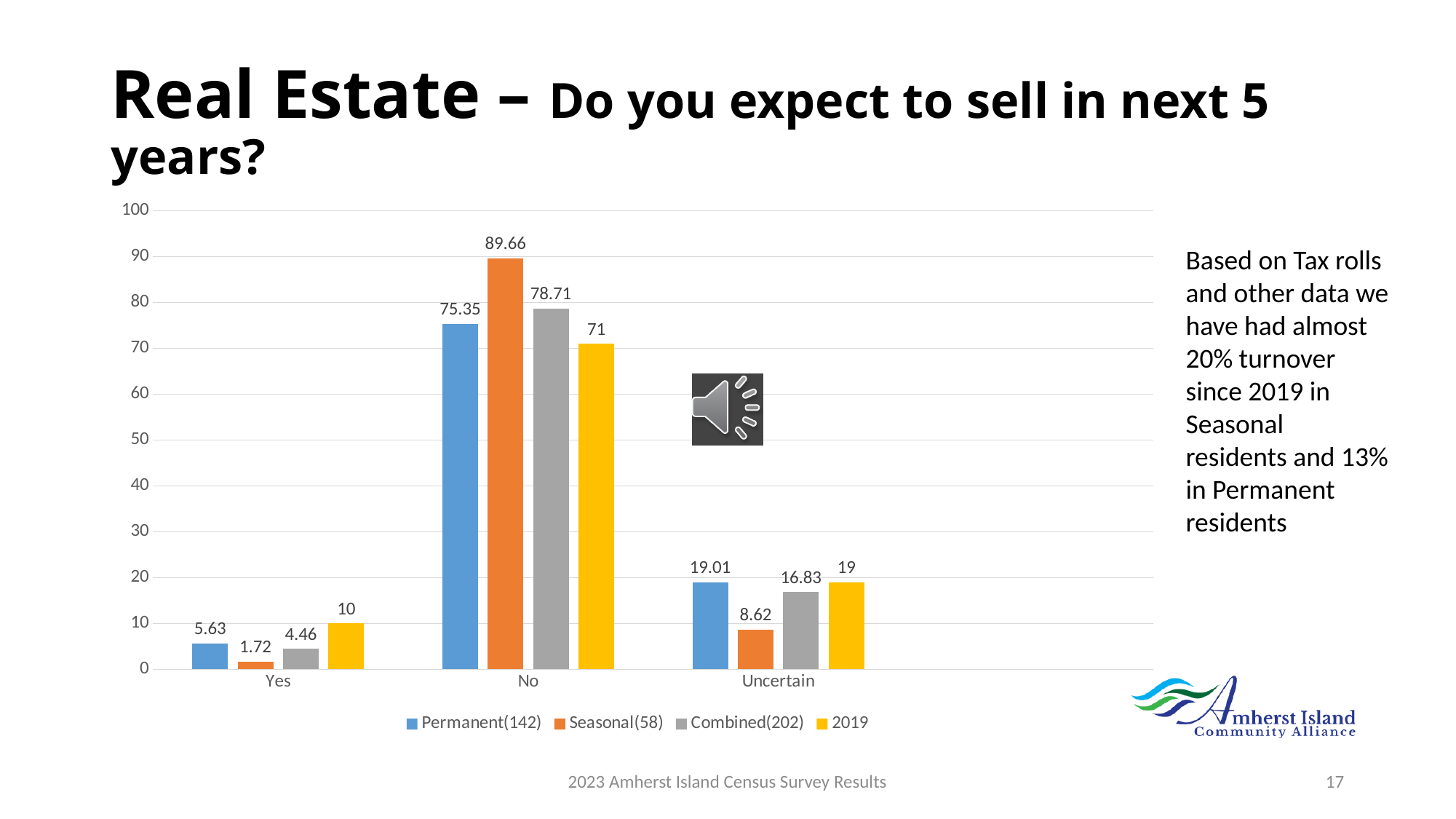
How many series does the legend list? 4 What is the value for Seasonal(58) in the No category? 89.66 What is the difference between the Combined(202) and Permanent(142) values in the No category? 3.36 Which colour represents the 2019 series in the legend? Yellow Which series has the lowest value in the Yes category? Seasonal(58) What is the value for 2019 in the Yes category? 10 How many categories are shown on the x axis? 3 What kind of chart is shown on the slide? Bar chart What is the value for Permanent(142) in the Uncertain category? 19.01 What is the difference between the Seasonal(58) and 2019 values in the Uncertain category? 10.38 Which is larger: the Permanent(142) value for Uncertain or the Combined(202) value for Uncertain? Permanent(142) Which series has the highest value in the No category? Seasonal(58)